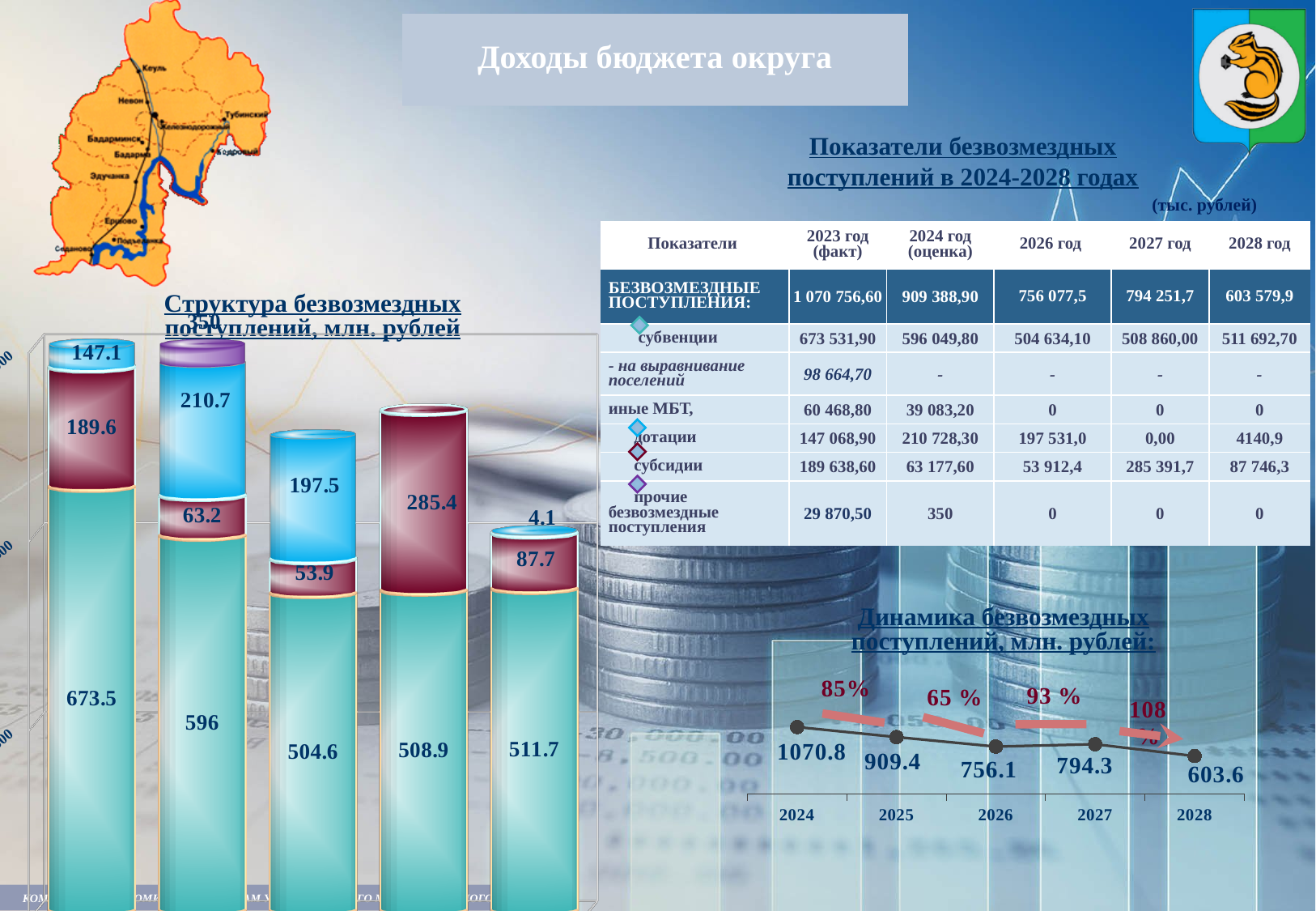
In the chart 'Динамика безвозмездных поступлений, млн. рублей', which year has the larger value, 2026 or 2027? 2027 In the chart 'Динамика безвозмездных поступлений, млн. рублей', what percentage label is shown between 2024 and 2025? 85% In the chart 'Динамика безвозмездных поступлений, млн. рублей', what is the difference between the values for 2024 and 2025? 161.4 In the chart 'Динамика безвозмездных поступлений, млн. рублей', what is the value for 2028? 603.6 In the chart 'Структура безвозмездных поступлений, млн. рублей', what is the total of the fourth bar from the left (508.9 and 285.4)? 794.3 In the chart 'Динамика безвозмездных поступлений, млн. рублей', which year has the lowest value? 2028 How many years are plotted in the chart 'Динамика безвозмездных поступлений, млн. рублей'? 5 What kind of chart is 'Динамика безвозмездных поступлений, млн. рублей'? line chart In the chart 'Динамика безвозмездных поступлений, млн. рублей', what is the value for 2026? 756.1 In the chart 'Динамика безвозмездных поступлений, млн. рублей', which year has the highest value? 2024 What kind of chart is 'Структура безвозмездных поступлений, млн. рублей'? stacked bar chart In the chart 'Динамика безвозмездных поступлений, млн. рублей', do the values generally rise or fall from 2024 to 2028? fall